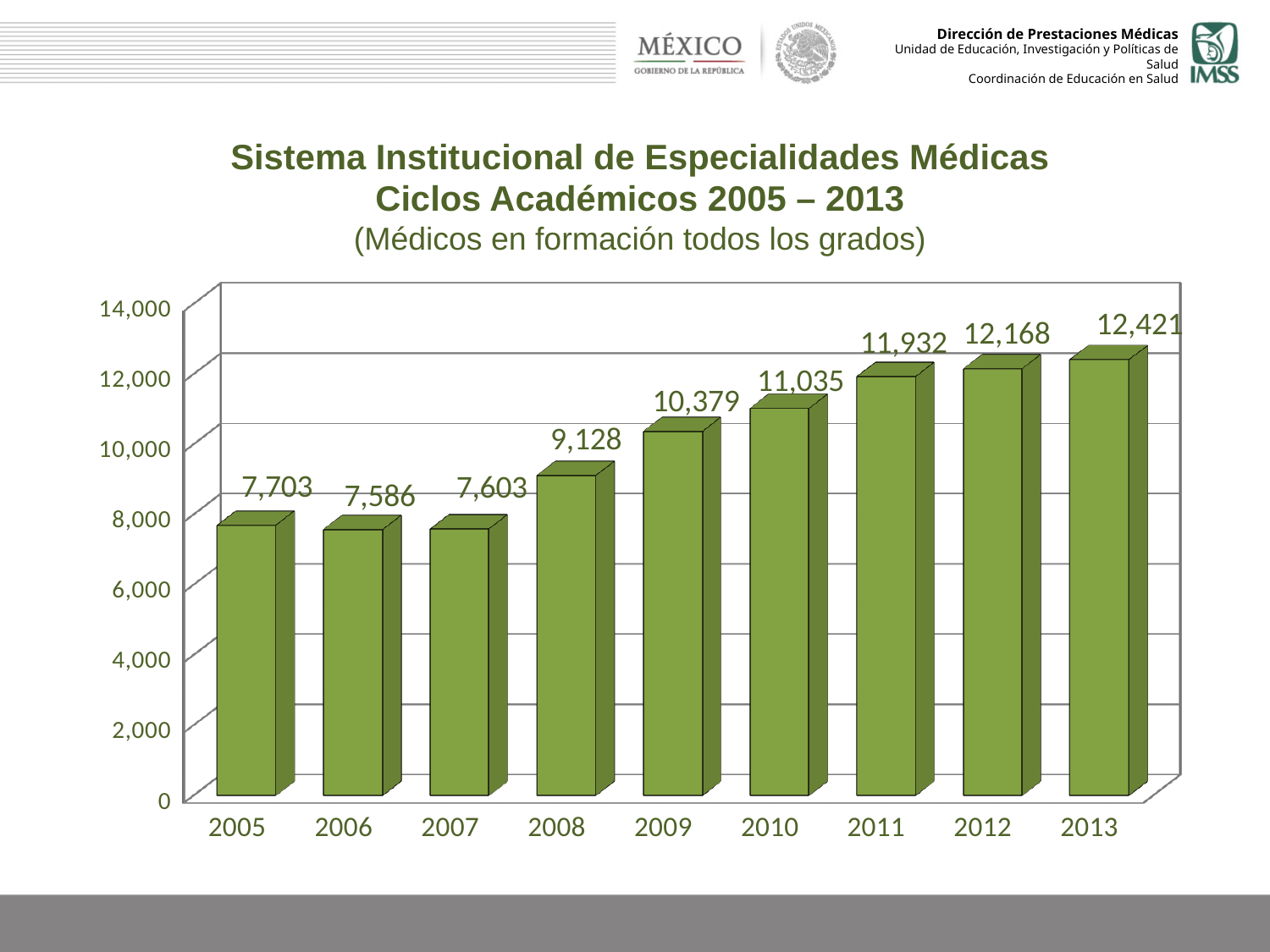
Which year has the lowest value? 2006 Do the values generally rise or fall from 2007 to 2013? rise Which is larger, the value for 2010 or the value for 2008? 2010 Is the value for 2011 greater or less than 10,000? greater What is the value for 2012? 12,168 What is the difference between the values for 2013 and 2005? 4,718 What is the value for 2005? 7,703 Which year has the highest value? 2013 What kind of chart is shown on the slide? bar chart What is the difference between the values for 2008 and 2007? 1,525 What is the value for 2009? 10,379 How many years are shown on the x axis? 9